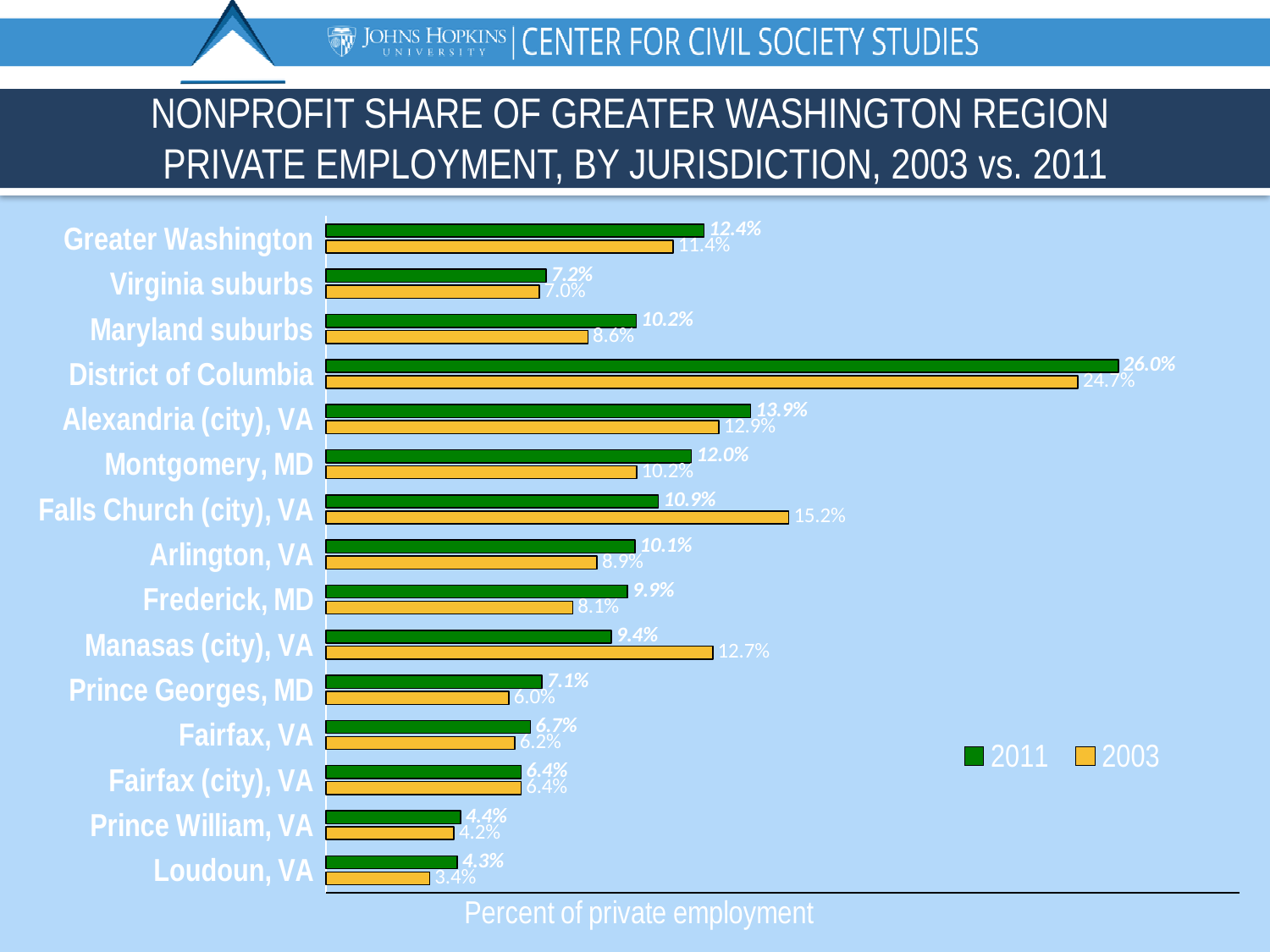
Which jurisdiction had the highest nonprofit share of private employment in 2011? District of Columbia What was the 2011 value for Greater Washington? 12.4% For Manasas (city), VA, which year had the larger nonprofit share: 2003 or 2011? 2003 Which colour represents the year 2003 in the chart? Yellow What is the difference between the 2011 and 2003 values for Montgomery, MD? 1.8% What was the nonprofit share of private employment in the District of Columbia in 2011? 26.0% How many series does the legend list? 2 Which jurisdiction had the lowest nonprofit share of private employment in 2003? Loudoun, VA What type of chart is shown on the slide? Bar chart Which had a higher 2011 value: Alexandria (city), VA or Arlington, VA? Alexandria (city), VA How many jurisdictions are listed on the chart? 15 What was the nonprofit share of private employment in Falls Church (city), VA in 2003? 15.2%